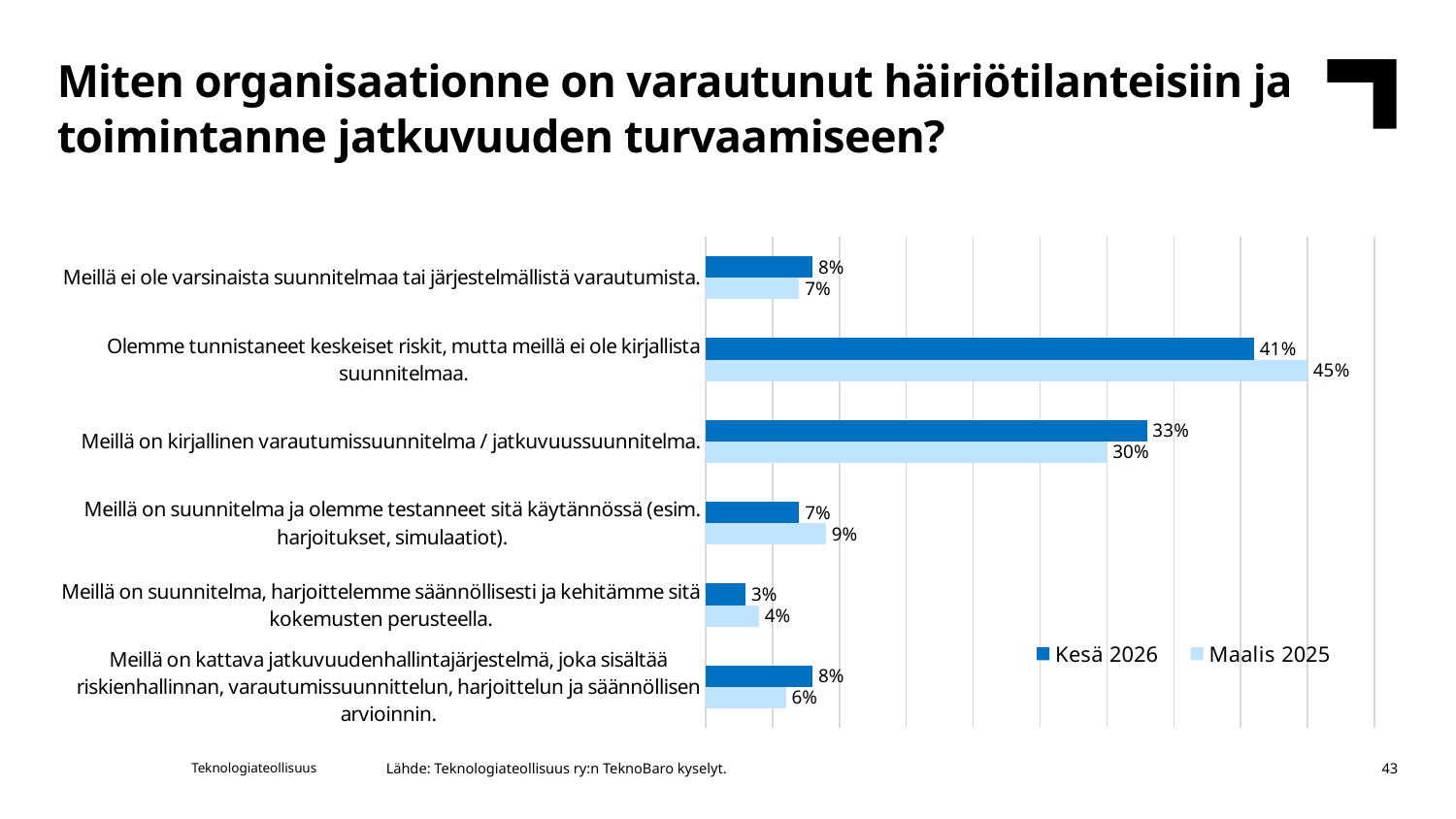
What is the difference between the Kesä 2026 and Maalis 2025 values for "Meillä on kattava jatkuvuudenhallintajärjestelmä, joka sisältää riskienhallinnan, varautumissuunnittelun, harjoittelun ja säännöllisen arvioinnin."? 2% How many categories are shown in the chart? 6 Which category has the highest Maalis 2025 value? Olemme tunnistaneet keskeiset riskit, mutta meillä ei ole kirjallista suunnitelmaa. What is the Maalis 2025 value for "Meillä on kirjallinen varautumissuunnitelma / jatkuvuussuunnitelma."? 30% What is the difference between the Maalis 2025 and Kesä 2026 values for "Olemme tunnistaneet keskeiset riskit, mutta meillä ei ole kirjallista suunnitelmaa."? 4% What kind of chart is shown on the slide? Bar chart How many series does the legend list? 2 Which colour represents the Maalis 2025 series in the chart? Light blue Which category has the lowest Kesä 2026 value? Meillä on suunnitelma, harjoittelemme säännöllisesti ja kehitämme sitä kokemusten perusteella. What is the Maalis 2025 value for "Meillä on suunnitelma ja olemme testanneet sitä käytännössä (esim. harjoitukset, simulaatiot)."? 9% What is the Kesä 2026 value for "Olemme tunnistaneet keskeiset riskit, mutta meillä ei ole kirjallista suunnitelmaa."? 41% For "Meillä on kirjallinen varautumissuunnitelma / jatkuvuussuunnitelma.", which series has the larger value, Kesä 2026 or Maalis 2025? Kesä 2026